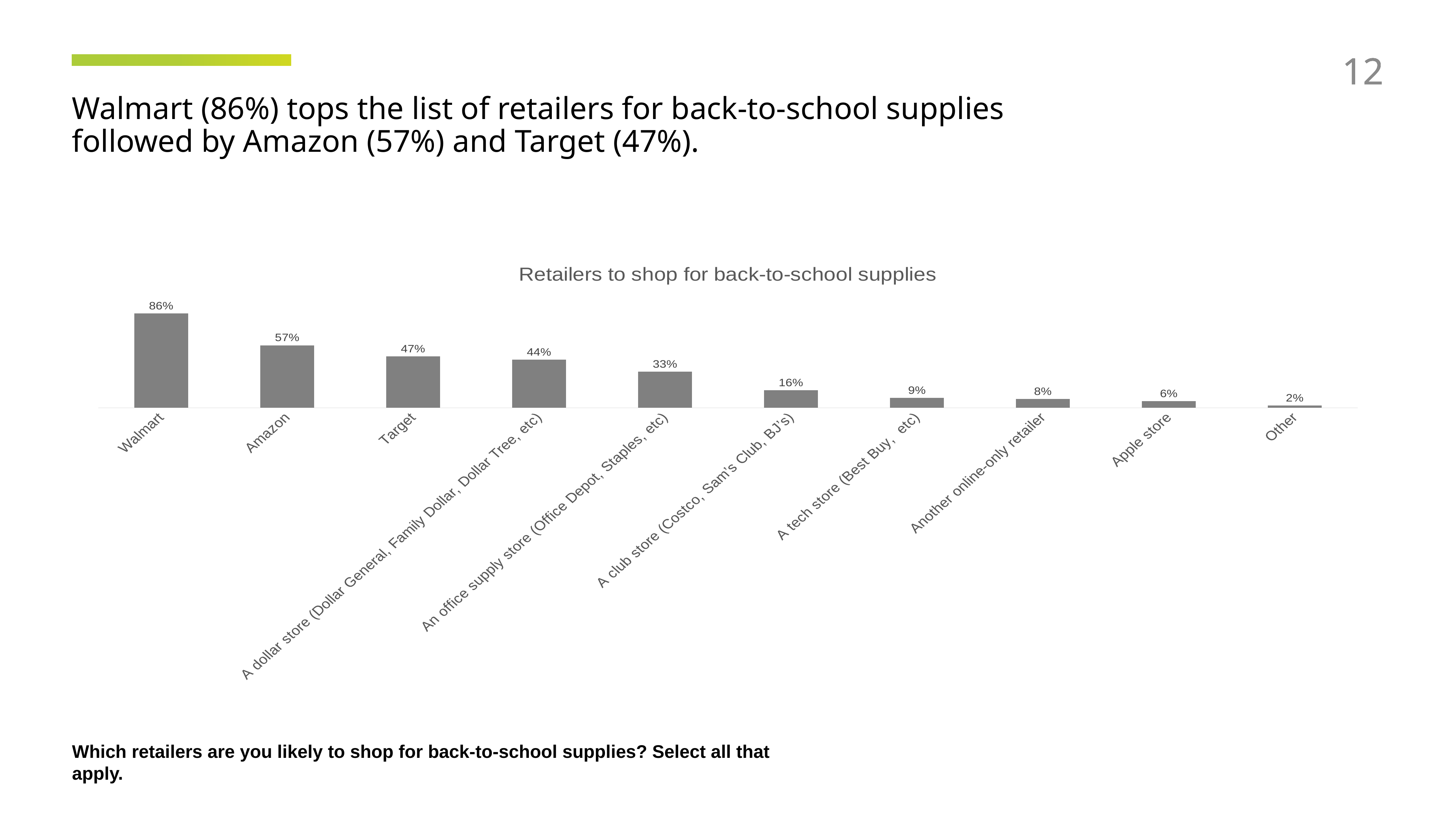
Which category has the lowest value in the chart? Other How many retailer categories are shown in the chart? 10 What is the value shown for Amazon? 57% What is the difference between the values for Walmart and Amazon? 29% What is the difference between the values for Target and A dollar store (Dollar General, Family Dollar, Dollar Tree, etc)? 3% Which has a higher value, A tech store (Best Buy, etc) or Another online-only retailer? A tech store (Best Buy, etc) What is the value shown for A club store (Costco, Sam's Club, BJ's)? 16% What percentage of respondents are likely to shop at Walmart for back-to-school supplies? 86% What is the title of the chart? Retailers to shop for back-to-school supplies Which retailer has the highest value in the chart? Walmart What is the value shown for Apple store? 6% What type of chart is shown on the slide? Bar chart